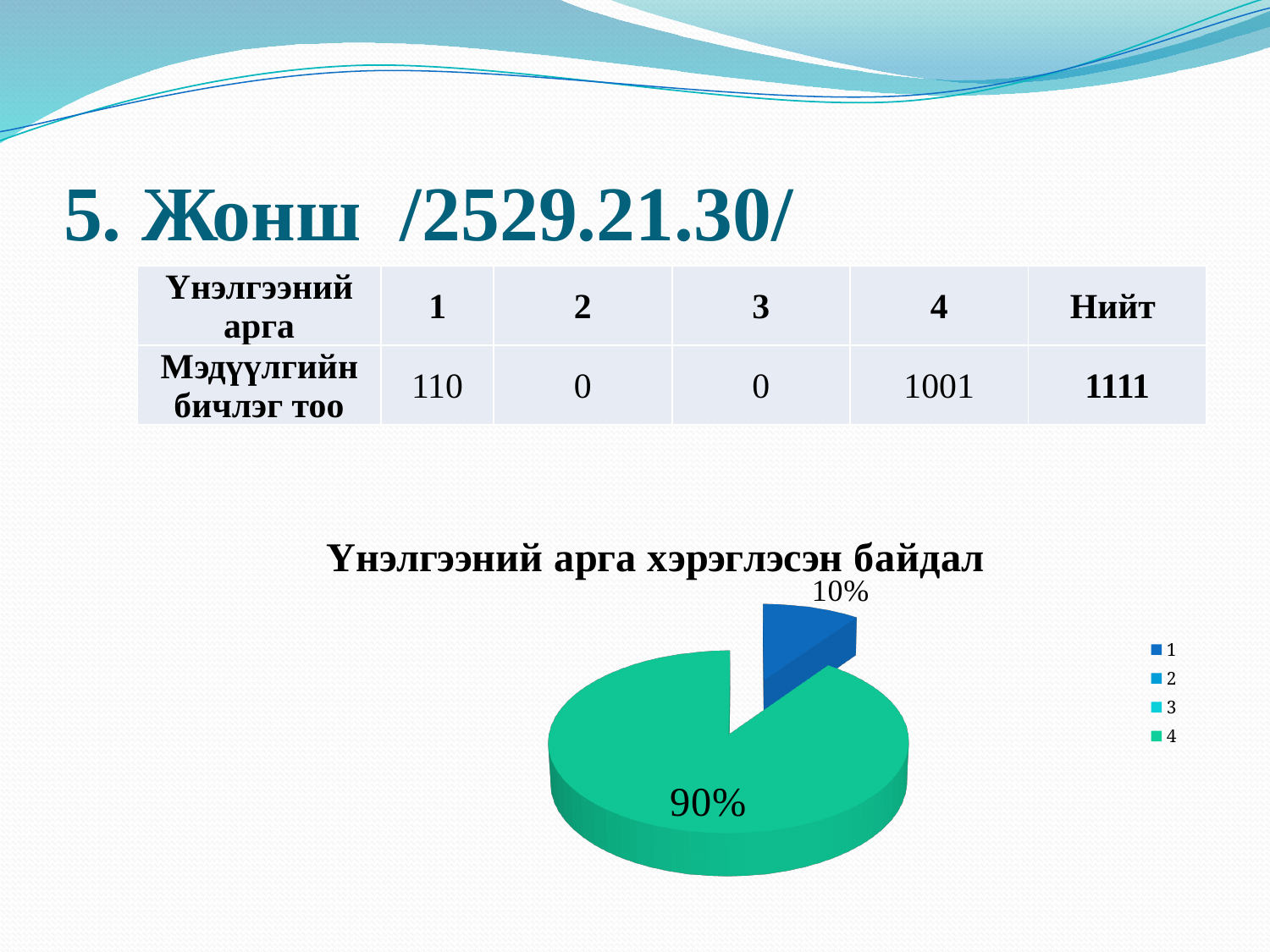
Which category has the largest slice in the pie chart? 4 What share of the pie does category 4 hold? 90% What colour is the slice labelled 90%? green What is the difference in percentage points between the slice for category 4 and the slice for category 1? 80 Which of the visible slices is smaller, category 1 or category 4? 1 What is the title of the pie chart? Үнэлгээний арга хэрэглэсэн байдал Is the share for category 4 greater or less than 50%? greater What share of the pie does category 1 hold? 10% What kind of chart is shown on the slide? pie chart How many slices are visibly drawn in the pie chart? 2 How many entries does the legend of the pie chart list? 4